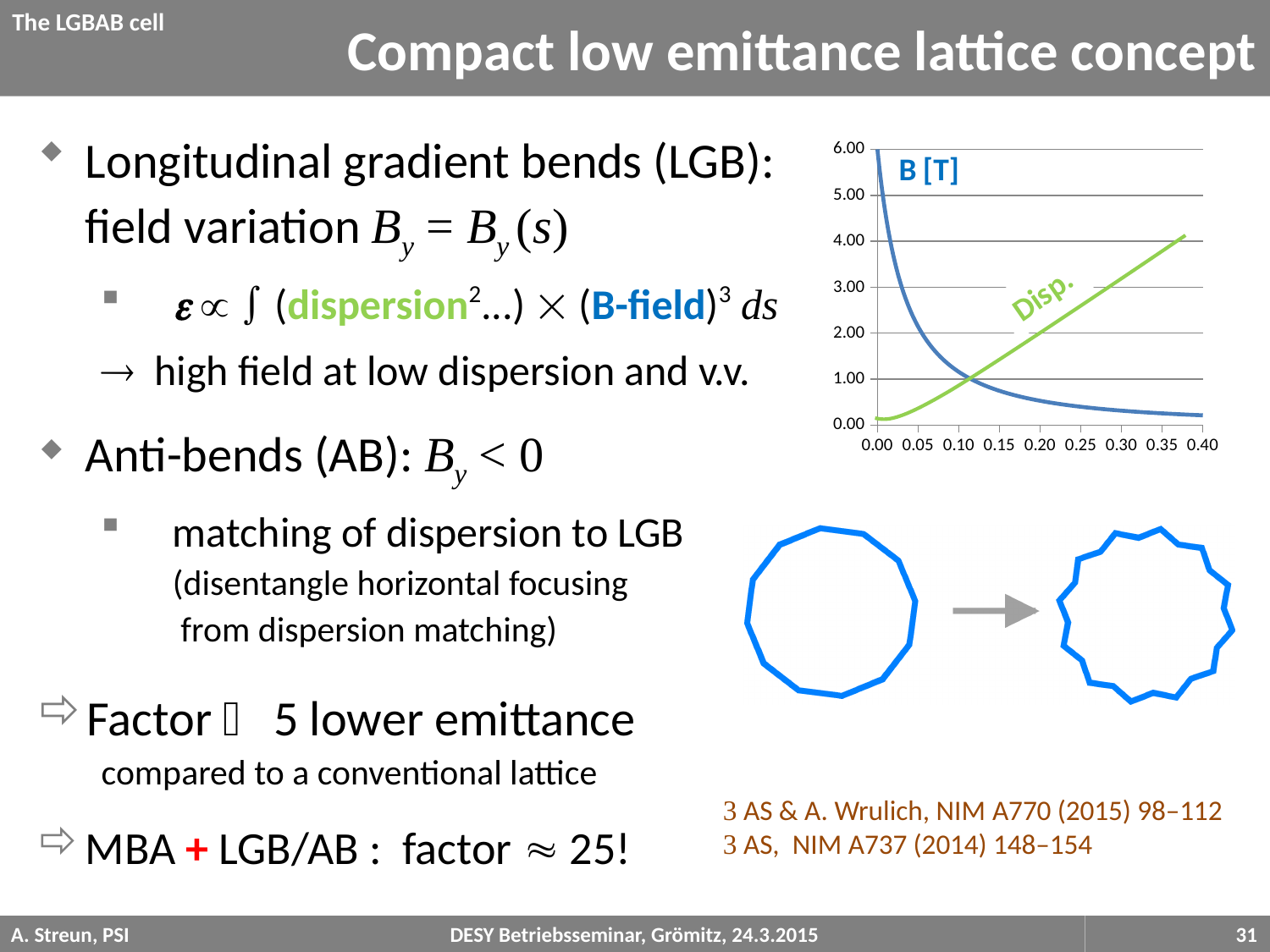
What are the two series labelled in the chart? B [T] and Disp. What is the maximum value shown on the vertical axis of the chart? 6.00 Is the value of Disp. at x = 0.25 greater or less than 2.00? greater Is the value of B [T] at x = 0.40 greater or less than 1.00? less Is the value of B [T] at x = 0.20 greater or less than 1.00? less Does the Disp. curve rise or fall as the x value increases? rise How many series are plotted in the chart? 2 Does the B [T] curve rise or fall as the x value increases? fall At x = 0.30, which series has the larger value, B [T] or Disp.? Disp. What kind of chart is shown on the slide? line chart At x = 0.05, which series has the larger value, B [T] or Disp.? B [T]